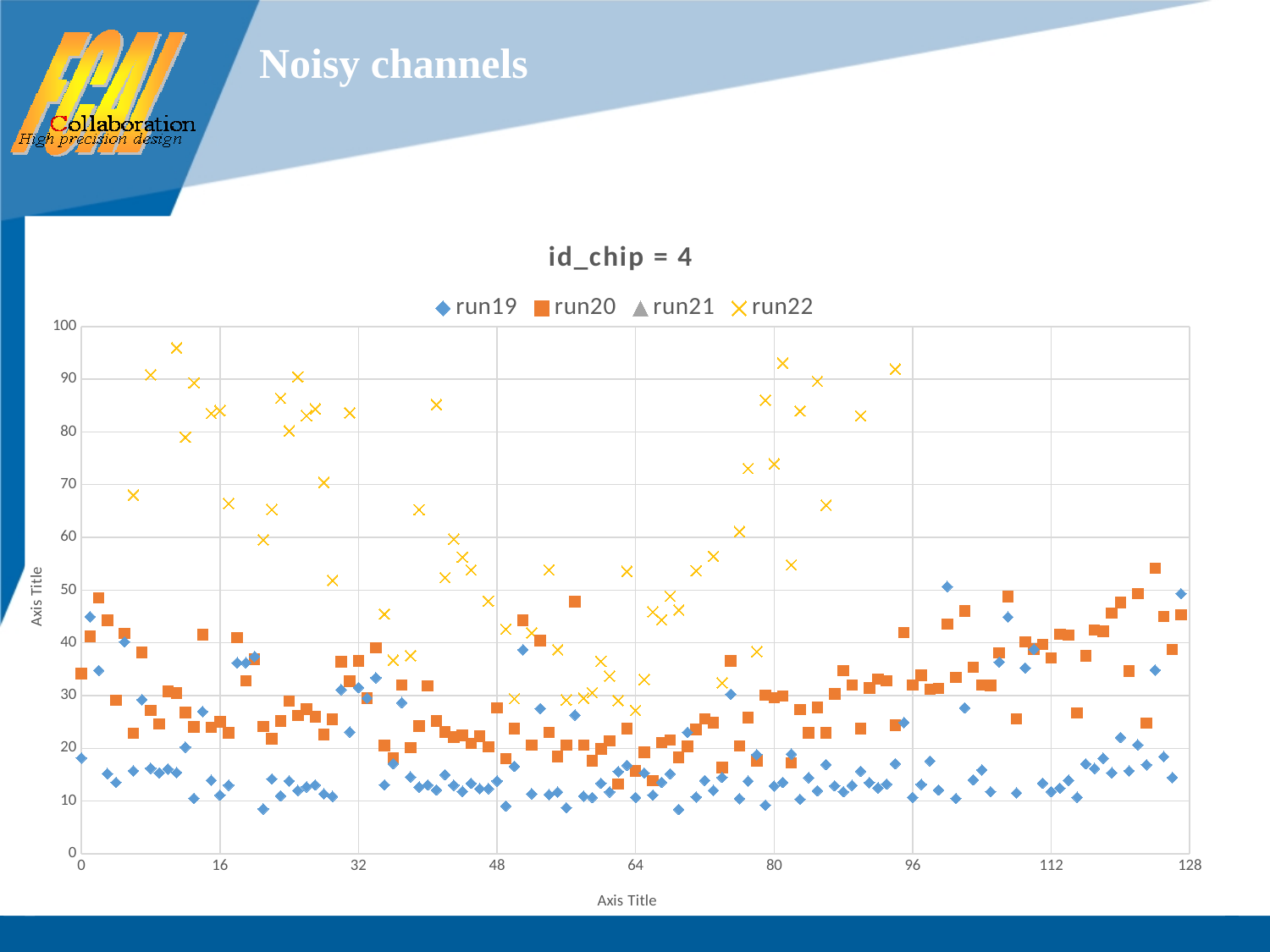
Is the highest run22 value greater or less than 90? greater How many series does the legend list? 4 Is the lowest run19 value greater or less than 10? less How many of the four legend series have visible data points on the chart? 3 Do the run20 values generally rise or fall between x = 96 and x = 128? rise What are the series names listed in the legend? run19, run20, run21, run22 Which series has the lowest plotted values overall? run19 Which series contains the highest plotted value on the chart? run22 What is the title of the chart? id_chip = 4 What kind of chart is shown on the slide? scatter chart Which series generally has larger values, run20 or run19? run20